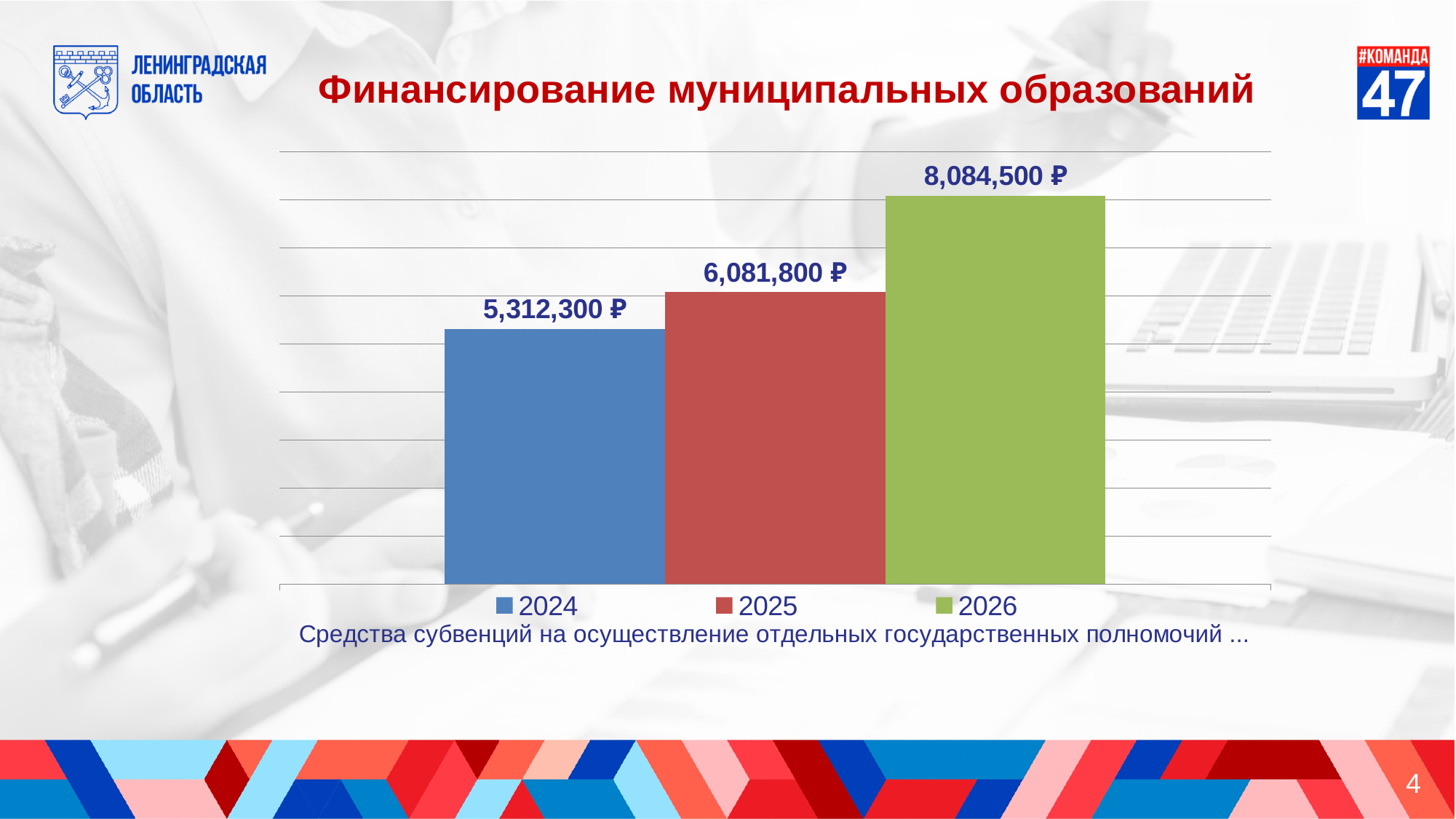
What is the difference between the values for 2025 and 2024? 769,500 ₽ What is the difference between the values for 2026 and 2025? 2,002,700 ₽ Which year has the lowest value? 2024 What is the difference between the values for 2026 and 2024? 2,772,200 ₽ What is the value shown for 2024? 5,312,300 ₽ What kind of chart is shown on the slide? Bar chart What is the value shown for 2026? 8,084,500 ₽ Which is larger, the value for 2025 or the value for 2026? 2026 What is the value shown for 2025? 6,081,800 ₽ How many entries does the legend list? 3 Which year has the highest value? 2026 How many bars are plotted in the chart? 3